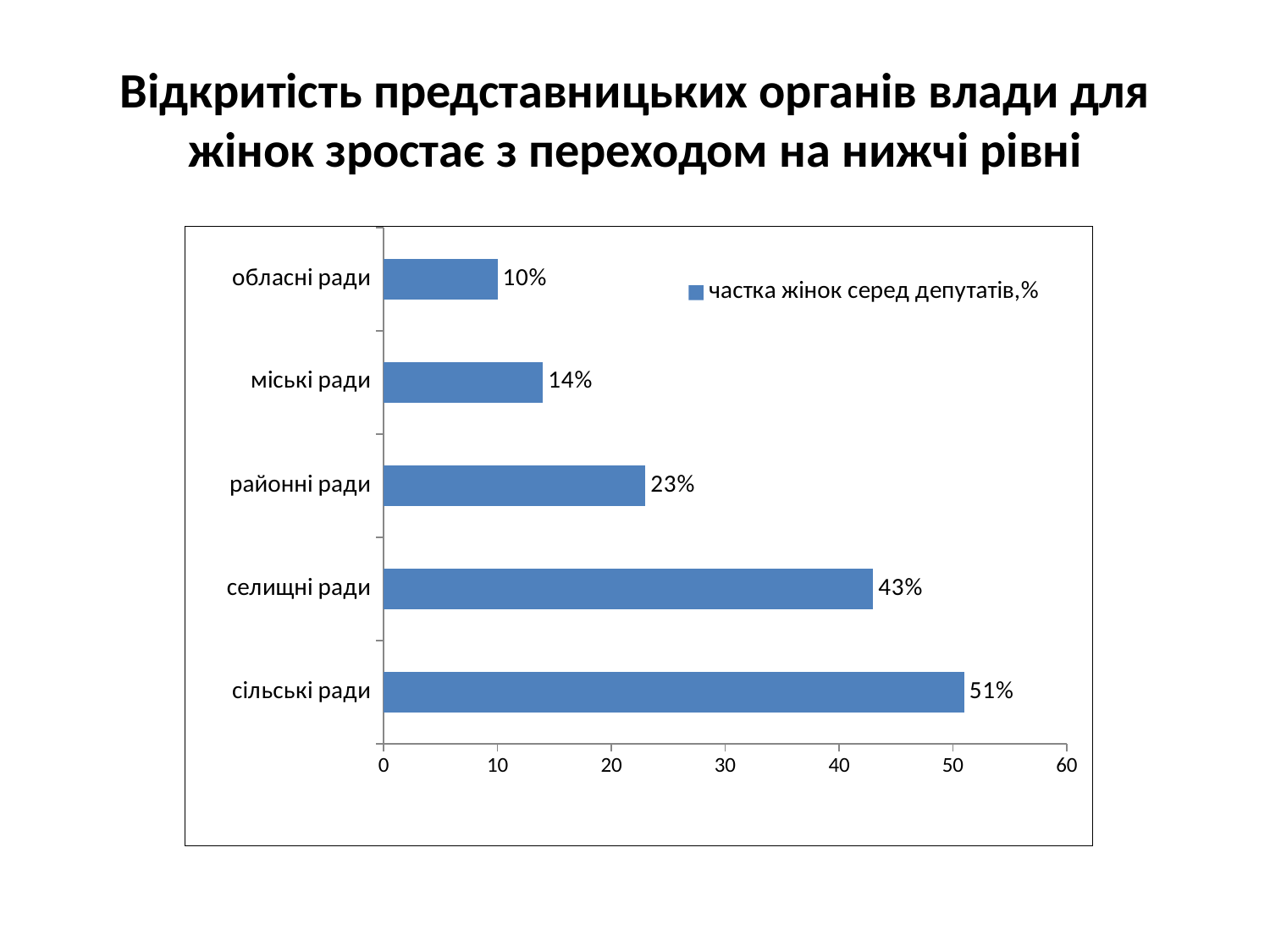
How many series does the legend list? 1 Which category has the highest value? сільські ради What kind of chart is shown on the slide? bar chart Which category has the lowest value? обласні ради What is the legend entry of the series shown in the chart? частка жінок серед депутатів,% Which is larger, the value for районні ради or the value for міські ради? районні ради What is the value for районні ради? 23% What is the value for обласні ради? 10% Is the value for селищні ради greater or less than 40? greater What is the value for сільські ради? 51% What is the difference between the values for селищні ради and міські ради? 29% How many categories are shown in the chart? 5